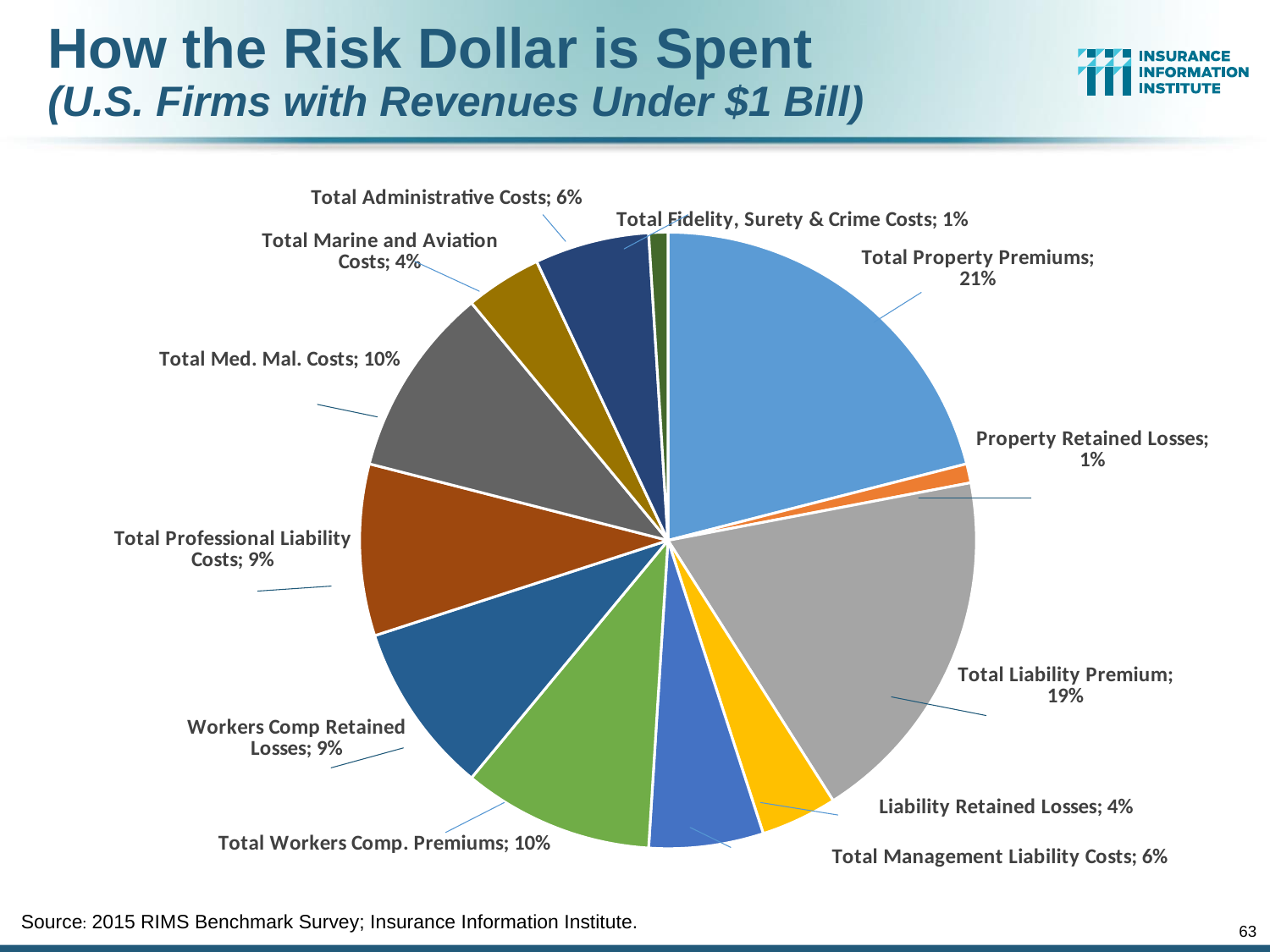
What share is shown for Total Fidelity, Surety & Crime Costs? 1% What share is labelled for Total Med. Mal. Costs? 10% How many slices does the pie chart have? 12 What percentage is shown for Total Marine and Aviation Costs? 4% What is the title of the chart on the slide? How the Risk Dollar is Spent (U.S. Firms with Revenues Under $1 Bill) Which is larger, Total Workers Comp. Premiums or Workers Comp Retained Losses? Total Workers Comp. Premiums What kind of chart is shown on the slide? Pie chart What percentage is shown for Total Liability Premium? 19% Which category has the largest share of the risk dollar? Total Property Premiums What share of the risk dollar goes to Total Property Premiums? 21% What is the difference between the shares for Total Property Premiums and Total Liability Premium? 2% Which is larger, Total Property Premiums or Total Liability Premium? Total Property Premiums